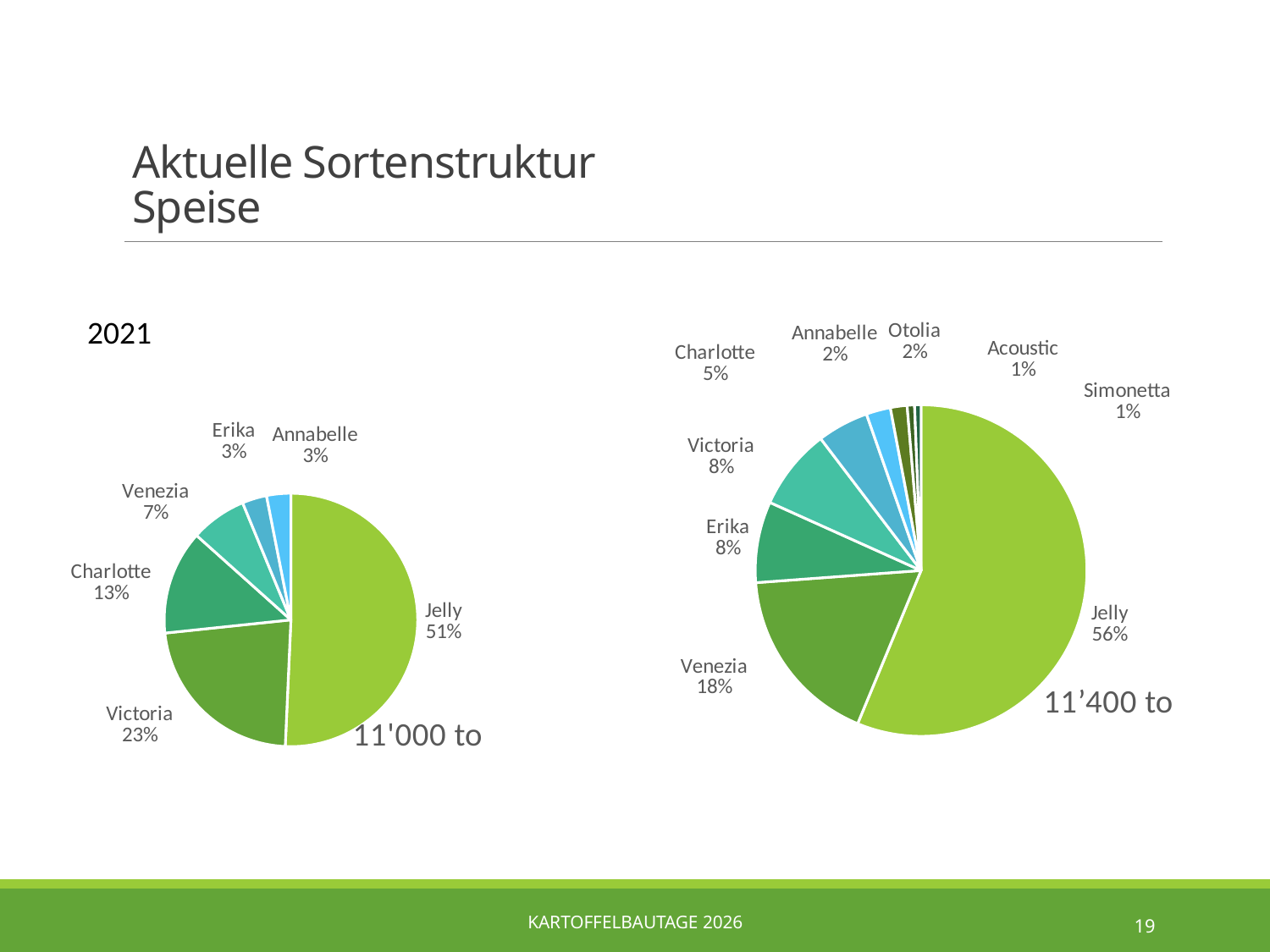
What total tonnage is printed next to the right pie chart? 11’400 to In the right pie chart, which variety has the largest share? Jelly In the right pie chart, what share does Charlotte have? 5% In the right pie chart, how many slices are there? 9 In the left pie chart (2021), what share does Jelly have? 51% In the left pie chart (2021), which variety has the largest share? Jelly In the left pie chart (2021), what share does Victoria have? 23% In the left pie chart (2021), how many slices are there? 6 What kind of chart is shown on the left of the slide? Pie chart In the right pie chart, which is larger, the share of Venezia or the share of Erika? Venezia In the left pie chart (2021), what is the difference between the shares of Victoria and Charlotte? 10%